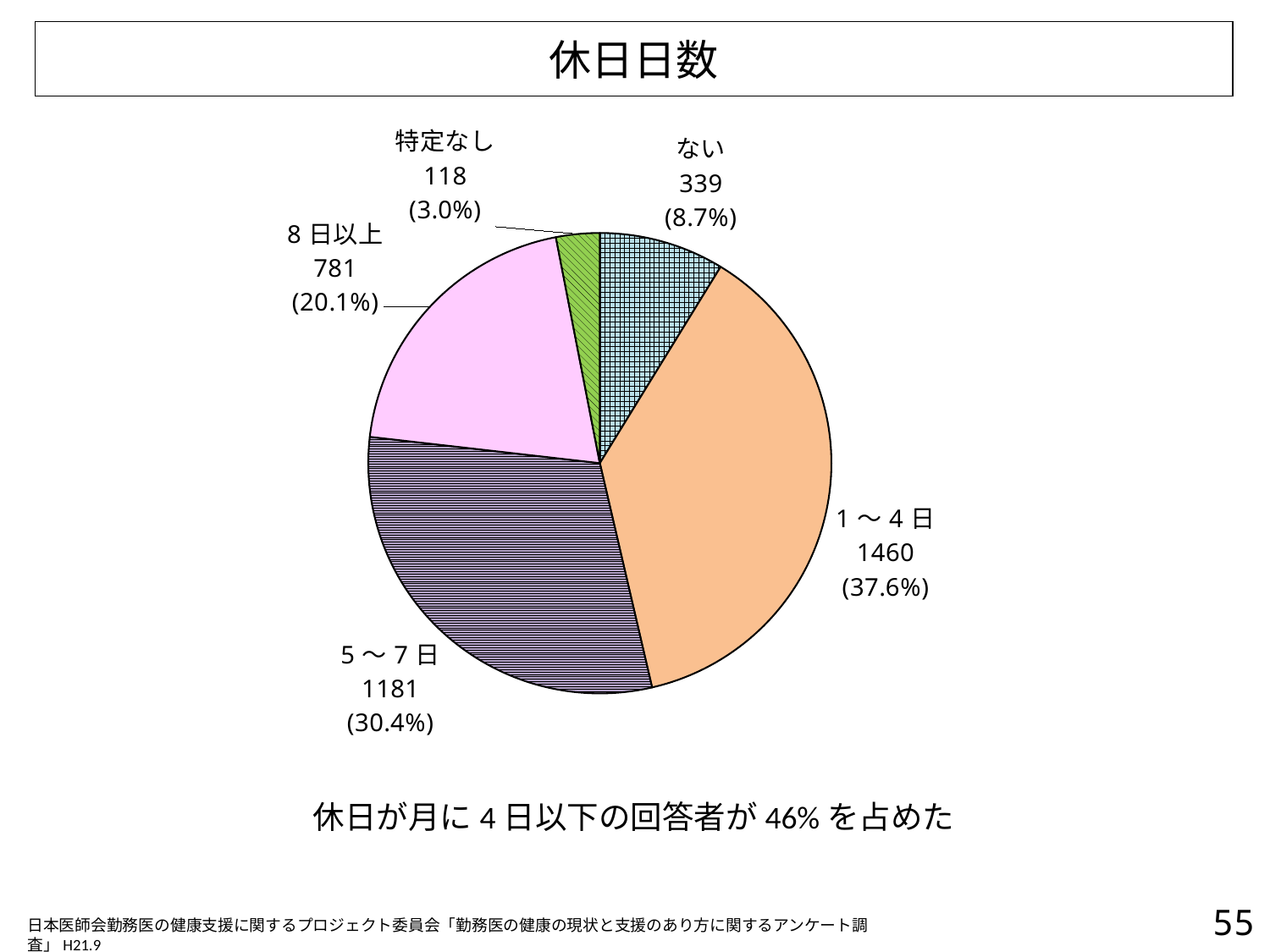
Which category has the largest slice? 1～4日 What is the difference in count between 1～4日 and 5～7日? 279 What kind of chart is shown on the slide? pie chart Which category has the smallest slice? 特定なし What percentage share does the 5～7日 slice have? 30.4% What is the title of the chart? 休日日数 How many slices does the pie chart have? 5 What is the combined count of the ない and 1～4日 slices? 1799 What is the count for the 1～4日 slice? 1460 What is the count for the 特定なし slice? 118 Which is larger, the count for 8日以上 or the count for ない? 8日以上 What percentage share does the ない slice have? 8.7%